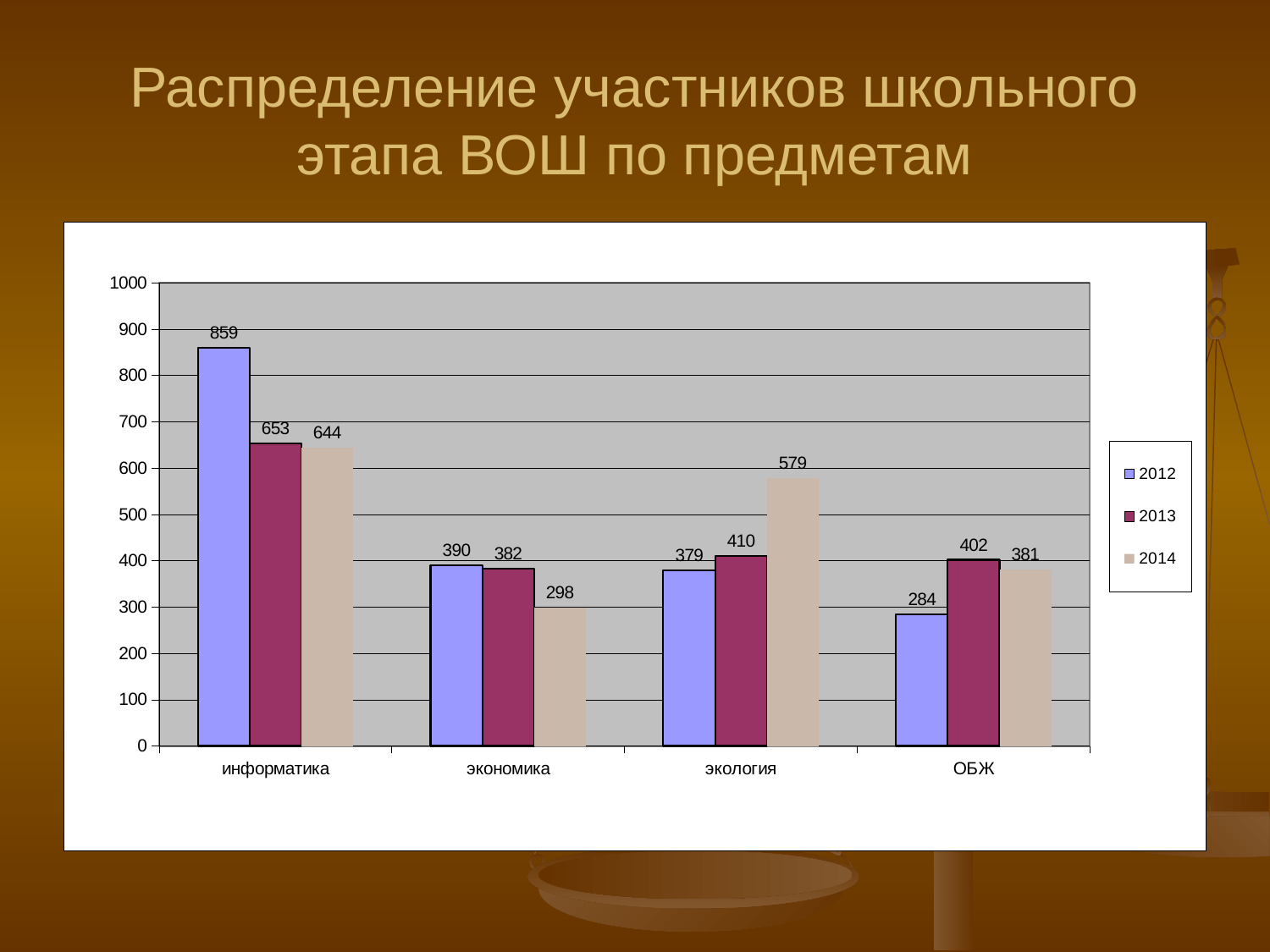
Which subject has the lowest value in 2014? экономика What is the value for информатика in 2012? 859 What is the difference between the 2012 and 2013 values for информатика? 206 How many subjects are shown on the x axis? 4 How many series does the legend list? 3 Which is larger: the 2014 value for экология or the 2014 value for ОБЖ? экология What kind of chart is shown on the slide? bar chart Do the values for информатика rise or fall from 2012 to 2014? fall Which subject has the highest value in 2012? информатика What is the value for экология in 2014? 579 What is the value for ОБЖ in 2013? 402 What is the value for экономика in 2014? 298